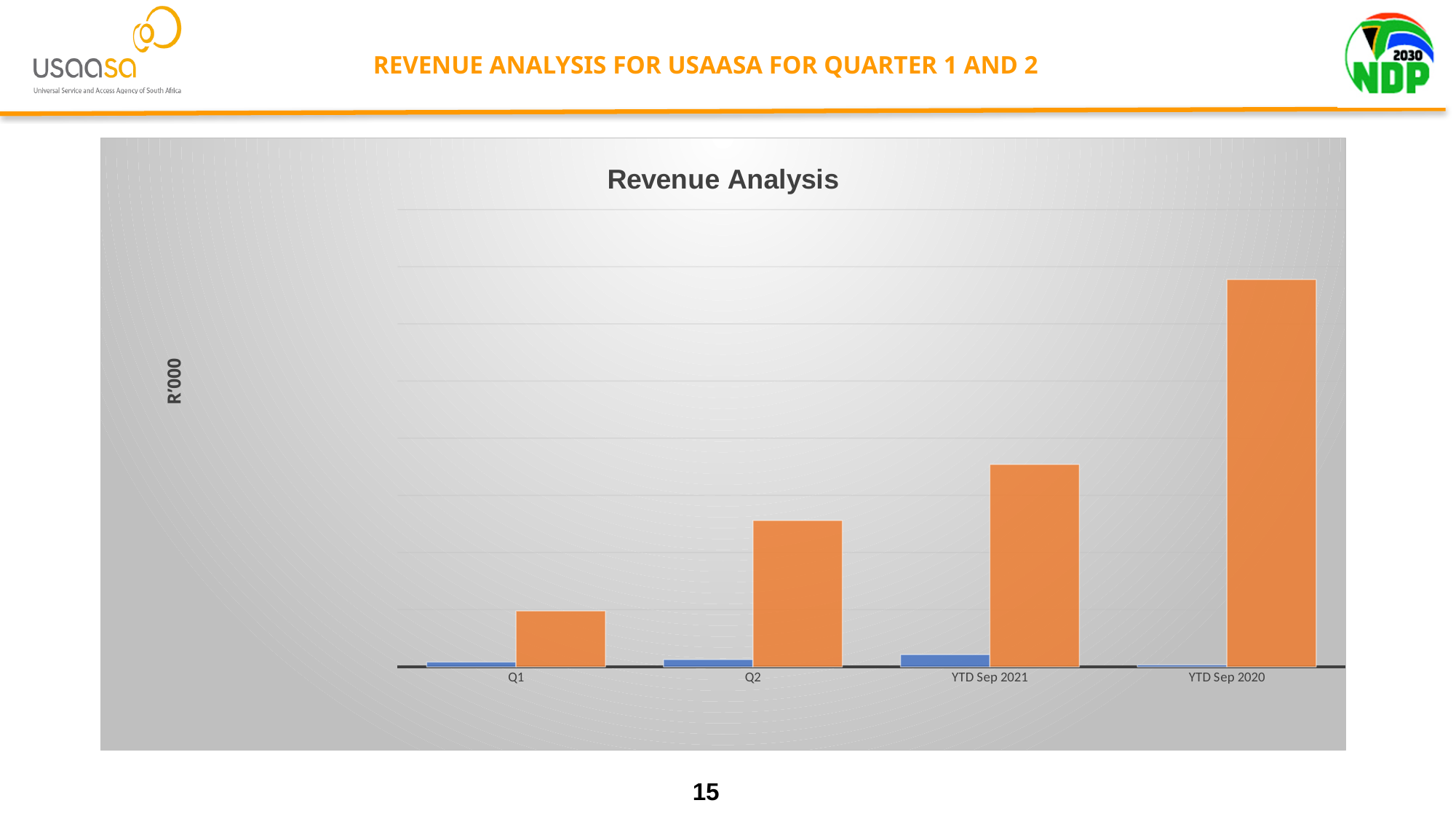
Which category has the shortest blue bar? YTD Sep 2020 Do the orange bars rise or fall from left to right across the x axis? rise Which category has the tallest orange bar? YTD Sep 2020 What kind of chart is shown on the slide? bar chart Which category has the shortest orange bar? Q1 What is the title of the chart? Revenue Analysis What label is shown on the vertical axis of the chart? R'000 How many categories are shown along the x axis of the chart? 4 Is the orange bar for Q2 taller or shorter than the orange bar for Q1? taller In the Q1 category, which bar is taller, the blue bar or the orange bar? the orange bar Which category has the tallest blue bar? YTD Sep 2021 Is the orange bar for YTD Sep 2021 taller or shorter than the orange bar for YTD Sep 2020? shorter